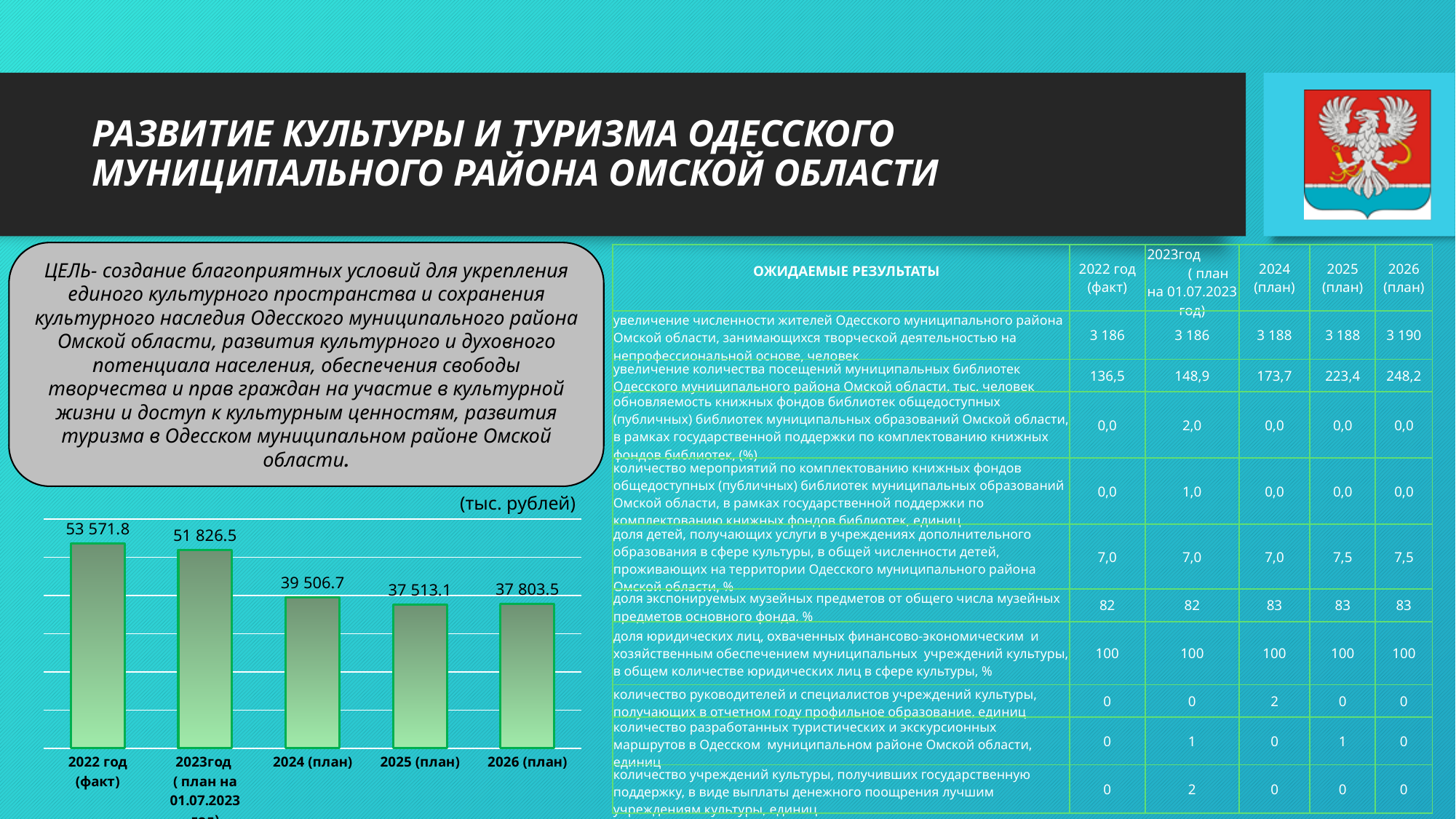
What is the value for 2022 год (факт) in the bar chart? 53 571.8 What is the difference between the values for 2024 (план) and 2025 (план) in the bar chart? 1 993.6 Which is larger in the bar chart: the value for 2023год (план на 01.07.2023 год) or the value for 2024 (план)? 2023год (план на 01.07.2023 год) Which category has the lowest value in the bar chart? 2025 (план) What kind of chart is shown on the slide? bar chart How many categories are shown in the bar chart? 5 What is the value for 2026 (план) in the bar chart? 37 803.5 Which category has the highest value in the bar chart? 2022 год (факт) What unit is indicated above the bar chart? тыс. рублей What is the value for 2024 (план) in the bar chart? 39 506.7 What is the difference between the values for 2022 год (факт) and 2023год (план на 01.07.2023 год) in the bar chart? 1 745.3 What is the value for 2025 (план) in the bar chart? 37 513.1